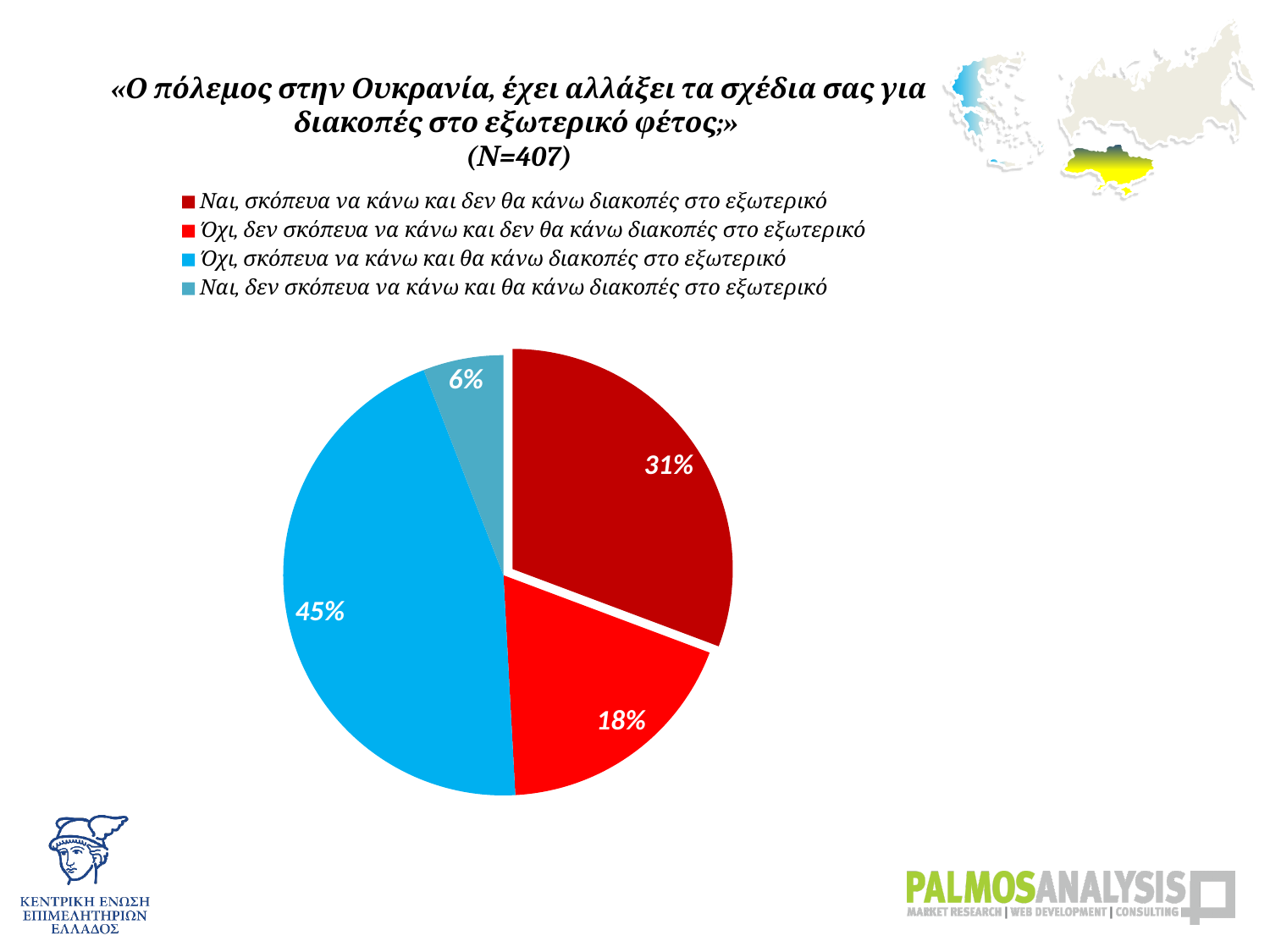
What is the sample size (N) stated in the chart title? 407 What percentage of respondents answered "Όχι, δεν σκόπευα να κάνω και δεν θα κάνω διακοπές στο εξωτερικό"? 18% What percentage of respondents answered "Ναι, σκόπευα να κάνω και δεν θα κάνω διακοπές στο εξωτερικό"? 31% How many entries does the legend list? 4 What is the difference in percentage points between the 45% slice and the 31% slice? 14 Which is larger: the share for "Ναι, σκόπευα να κάνω και δεν θα κάνω διακοπές στο εξωτερικό" or for "Όχι, δεν σκόπευα να κάνω και δεν θα κάνω διακοπές στο εξωτερικό"? Ναι, σκόπευα να κάνω και δεν θα κάνω διακοπές στο εξωτερικό What kind of chart is shown on the slide? pie chart How many slices does the pie chart have? 4 What percentage of respondents answered "Ναι, δεν σκόπευα να κάνω και θα κάνω διακοπές στο εξωτερικό"? 6% What percentage of respondents answered "Όχι, σκόπευα να κάνω και θα κάνω διακοπές στο εξωτερικό"? 45% Which response has the largest share of the pie? Όχι, σκόπευα να κάνω και θα κάνω διακοπές στο εξωτερικό Which response has the smallest share of the pie? Ναι, δεν σκόπευα να κάνω και θα κάνω διακοπές στο εξωτερικό